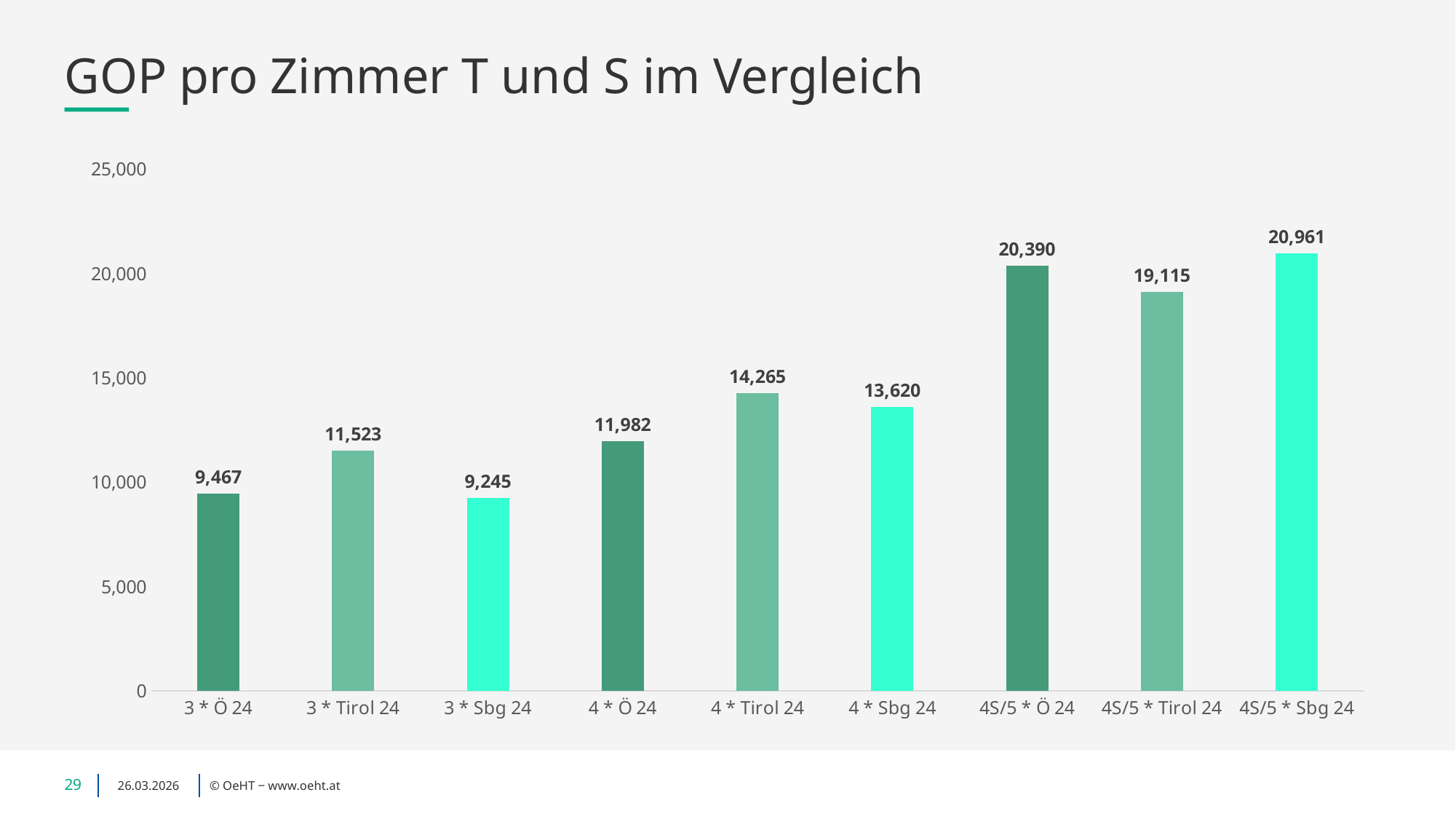
What is the value for 3 * Tirol 24? 11,523 What is the title of the slide? GOP pro Zimmer T und S im Vergleich What is the difference between 4 * Tirol 24 and 4 * Ö 24? 2,283 Is the value for 4S/5 * Tirol 24 greater or less than 20,000? less How many bars are shown in the chart? 9 What is the value for 4 * Sbg 24? 13,620 What is the value for 4S/5 * Ö 24? 20,390 Which category has the lowest value? 3 * Sbg 24 What is the difference between 4S/5 * Sbg 24 and 4S/5 * Tirol 24? 1,846 What kind of chart is shown on the slide? bar chart Which category has the highest value? 4S/5 * Sbg 24 Which is larger, 3 * Ö 24 or 3 * Sbg 24? 3 * Ö 24